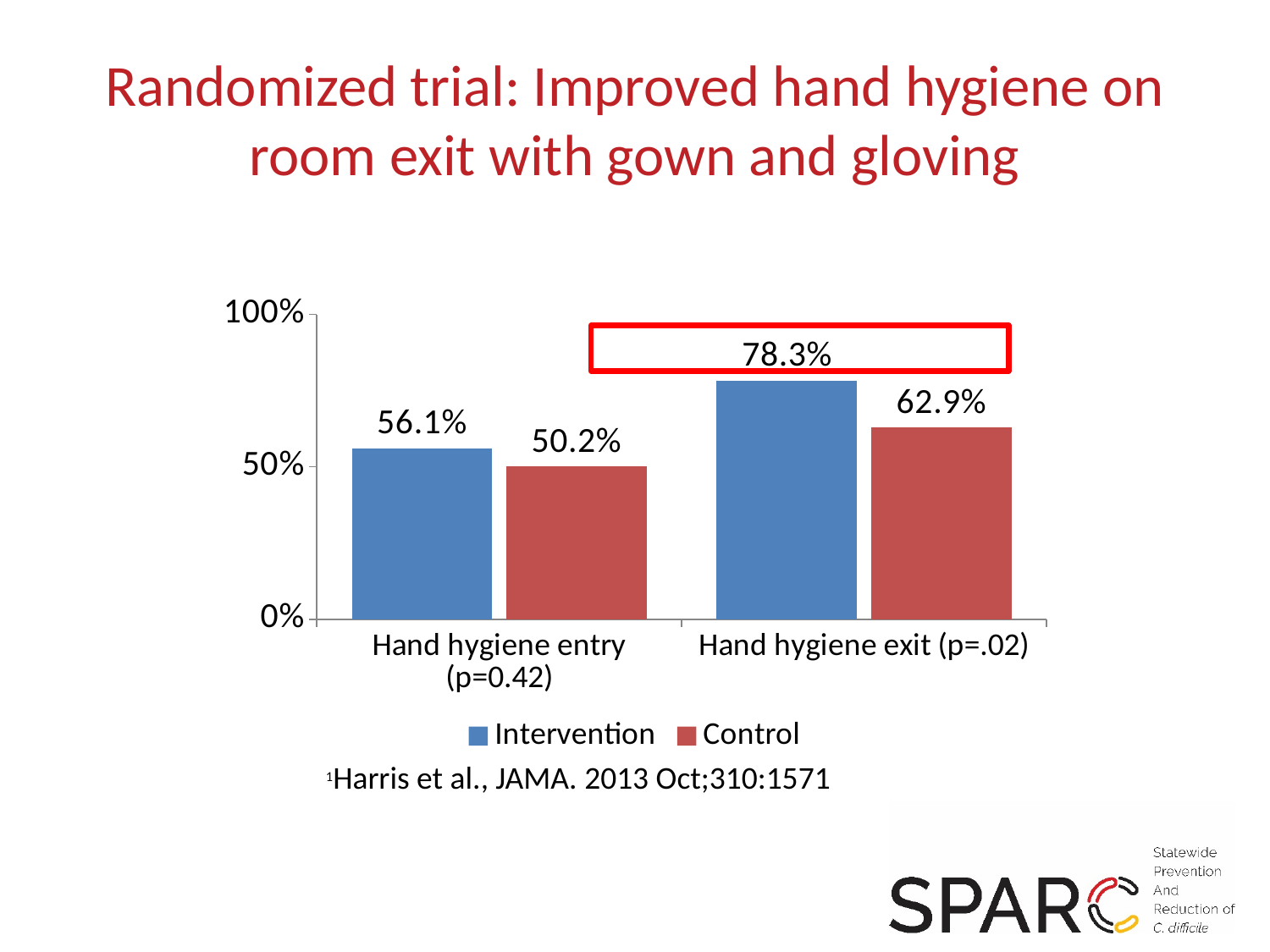
What is the Control value for Hand hygiene entry (p=0.42)? 50.2% Which bar has the highest value on the chart? Intervention, Hand hygiene exit (p=.02) What kind of chart is shown on the slide? Bar chart What colour represents the Control series in the legend? Red What is the difference between the Intervention and Control values for Hand hygiene exit (p=.02)? 15.4% What is the difference between the Intervention and Control values for Hand hygiene entry (p=0.42)? 5.9% What is the Control value for Hand hygiene exit (p=.02)? 62.9% How many series does the legend list? 2 Which bar has the lowest value on the chart? Control, Hand hygiene entry (p=0.42) What is the Intervention value for Hand hygiene entry (p=0.42)? 56.1% Which is larger for Hand hygiene exit (p=.02): Intervention or Control? Intervention What is the Intervention value for Hand hygiene exit (p=.02)? 78.3%